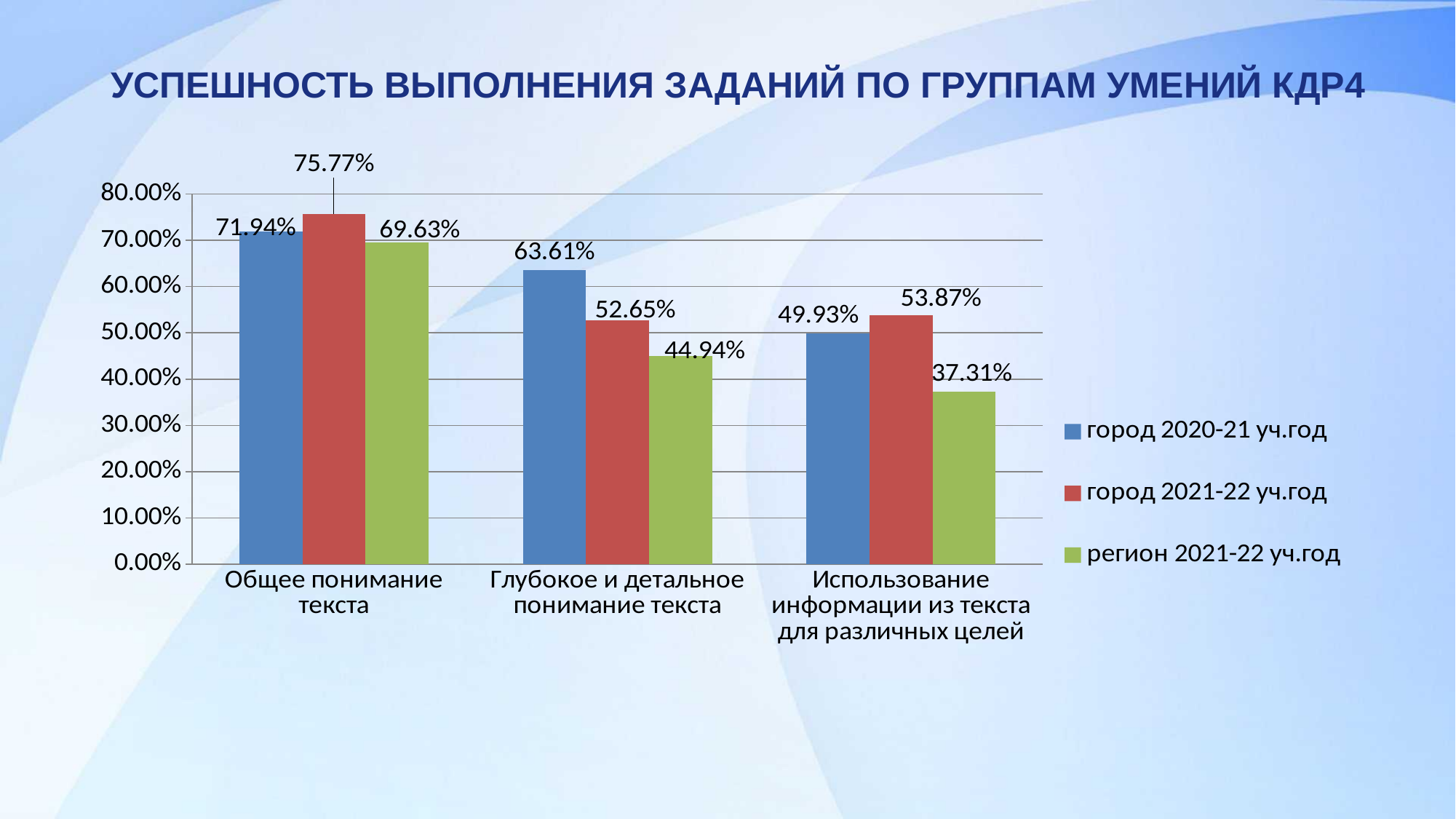
How many series does the legend list? 3 In the category "Общее понимание текста", which is larger: "город 2020-21 уч.год" or "регион 2021-22 уч.год"? город 2020-21 уч.год What colour are the bars for the series "город 2021-22 уч.год"? red What is the value for "город 2021-22 уч.год" in the category "Общее понимание текста"? 75.77% What is the value for "регион 2021-22 уч.год" in the category "Использование информации из текста для различных целей"? 37.31% What is the difference between "город 2021-22 уч.год" and "регион 2021-22 уч.год" in the category "Использование информации из текста для различных целей"? 16.56% Is the value for "город 2020-21 уч.год" in the category "Использование информации из текста для различных целей" greater or less than 60.00%? less How many categories are shown on the x axis? 3 What kind of chart is shown on the slide? bar chart Which category has the highest value for the series "регион 2021-22 уч.год"? Общее понимание текста What is the value for "город 2020-21 уч.год" in the category "Глубокое и детальное понимание текста"? 63.61% Which series has the lowest value in the category "Глубокое и детальное понимание текста"? регион 2021-22 уч.год